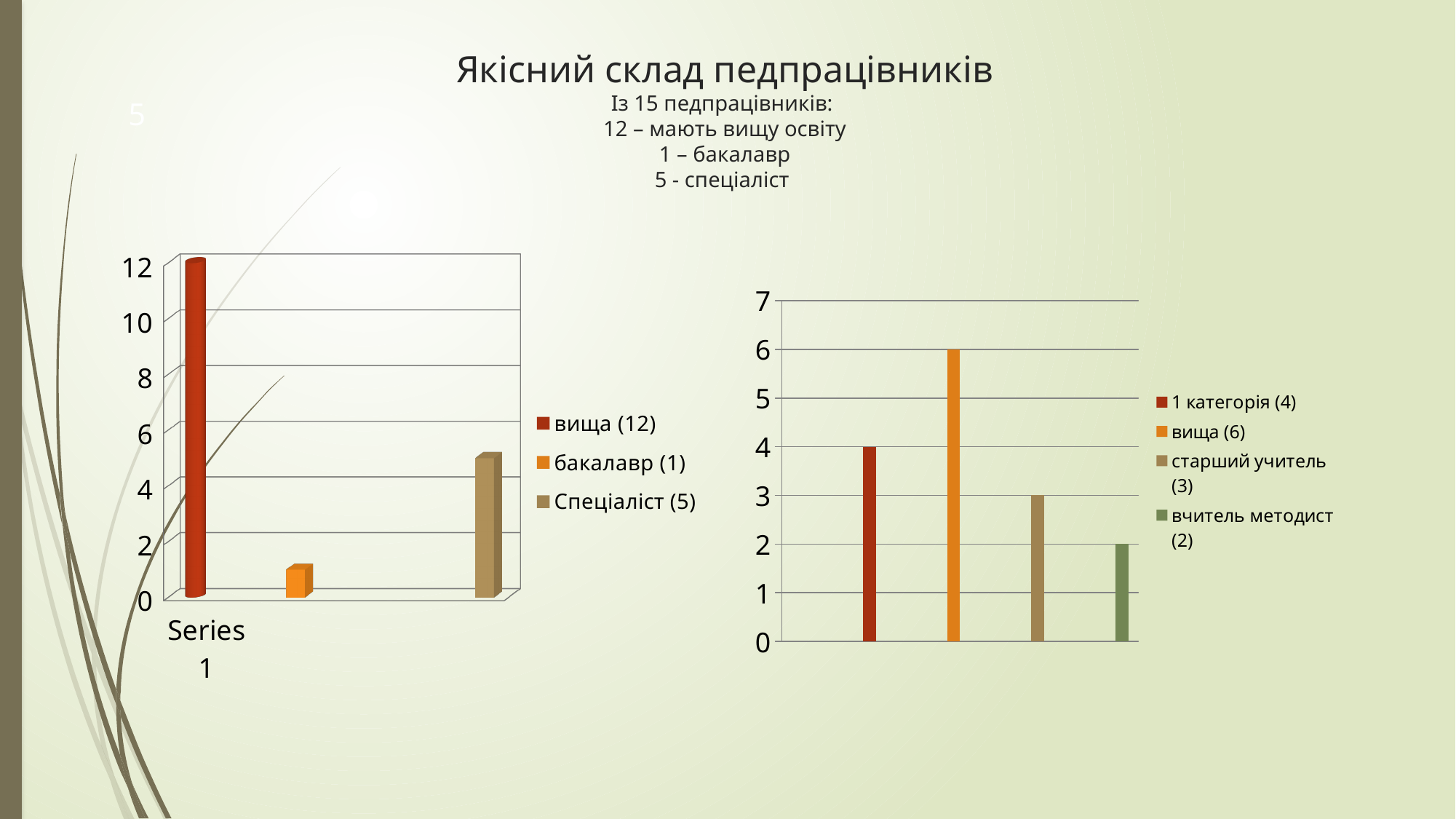
How many series does the legend of the left chart list? 3 On the right chart, which is larger: 1 категорія or старший учитель? 1 категорія On the right chart, which category has the lowest value? вчитель методист On the left chart, which category has the lowest value? бакалавр On the left chart, what is the difference between вища and Спеціаліст? 7 On the right chart, what is the value for вища? 6 How many series does the legend of the right chart list? 4 On the left chart, what is the value for вища? 12 What type of chart is the right chart? bar chart On the right chart, what is the value for старший учитель? 3 On the right chart, which category has the highest value? вища On the left chart, what is the value for Спеціаліст? 5